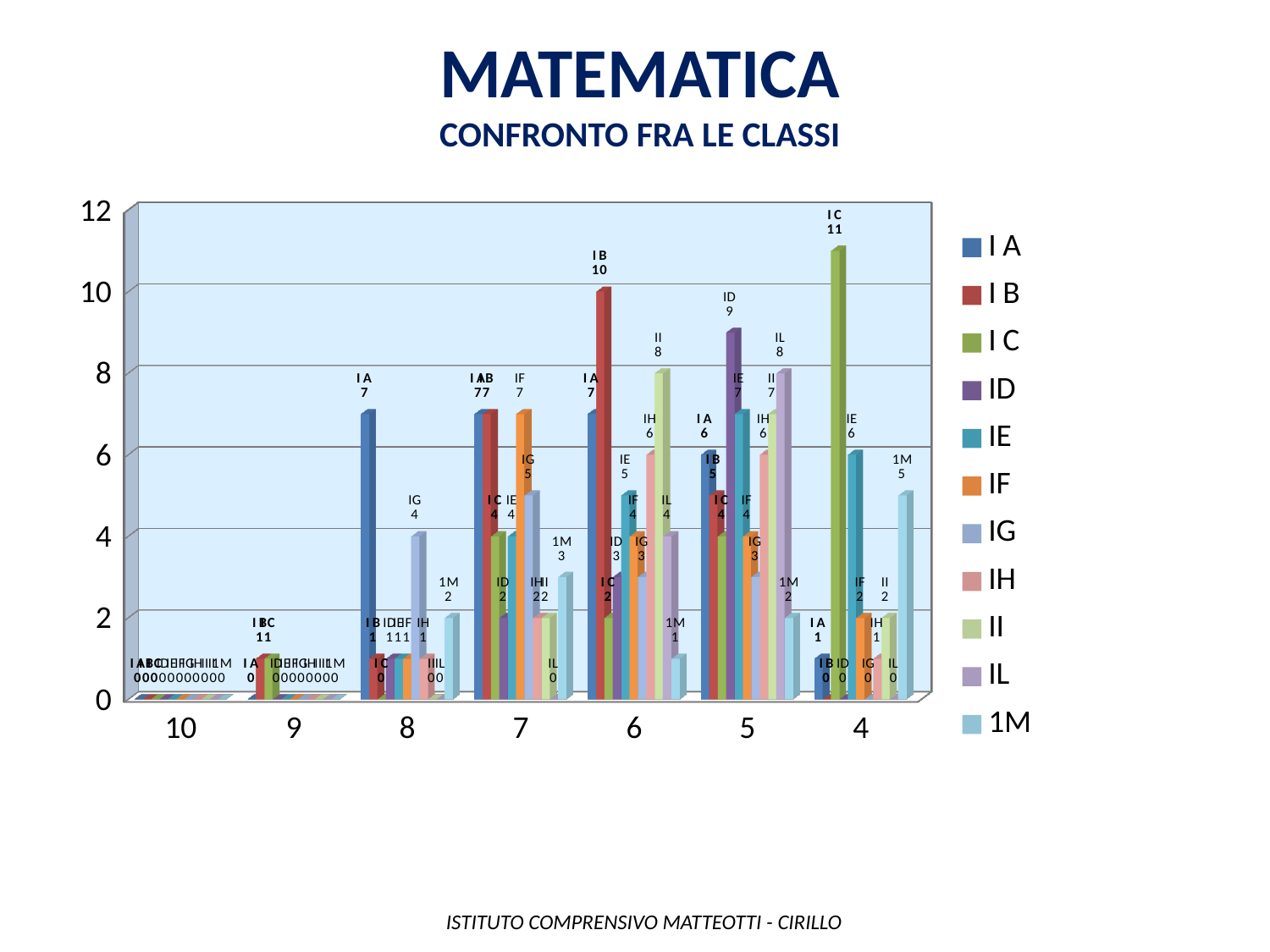
What is the value for 1M in category 7? 3 What is the difference between the values for I B and I A in category 6? 3 In category 4, which is larger: the value for IE or the value for 1M? IE What is the value for I C in category 4? 11 What kind of chart is shown on the slide? bar chart What is the value for I B in category 6? 10 What is the value for ID in category 5? 9 How many series does the legend list? 11 Which series has the highest value in category 5? ID What is the main title of the chart? MATEMATICA Which series has the highest value in the whole chart? I C How many categories are shown along the x axis? 7